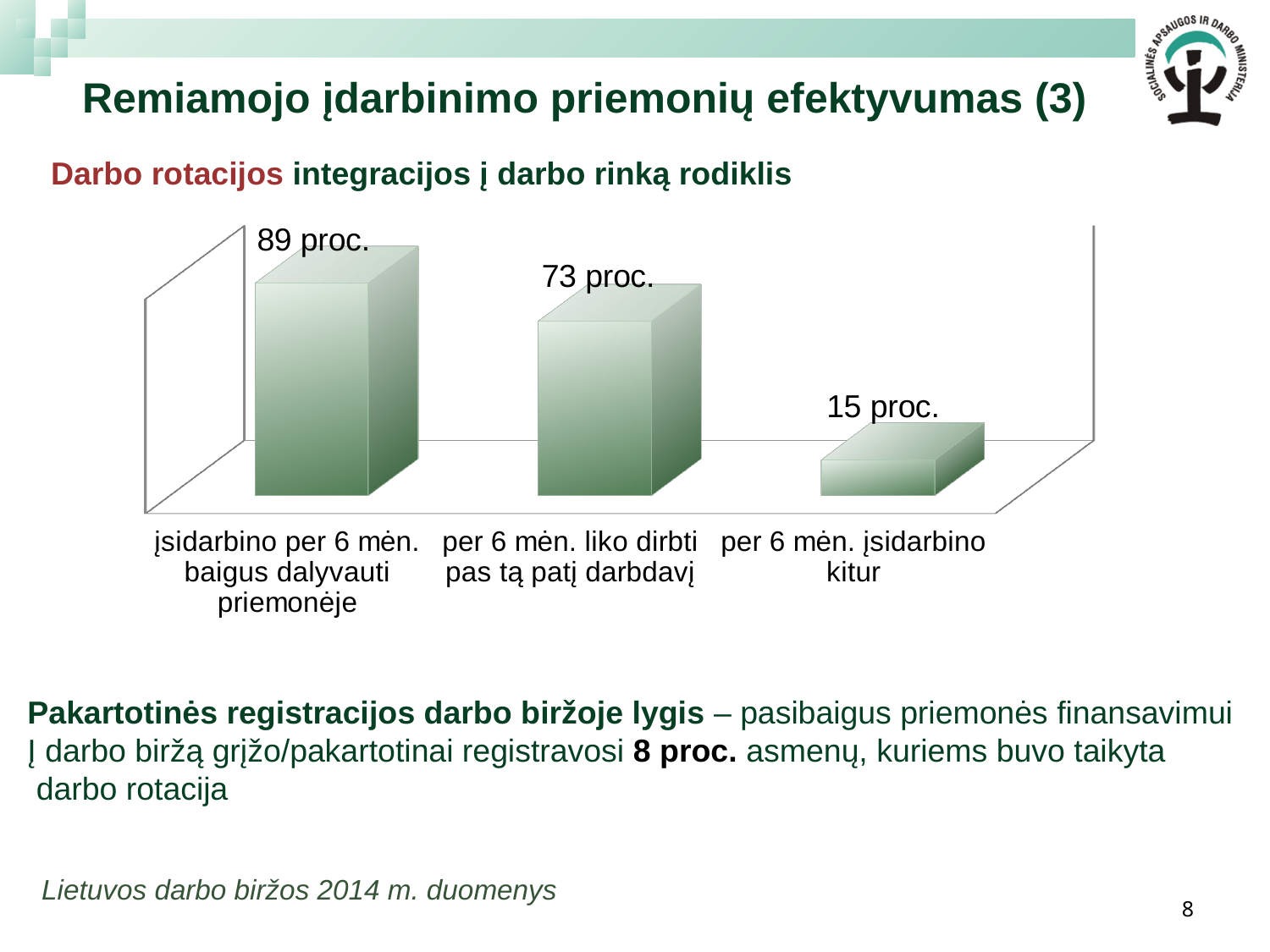
How many categories are shown in the chart? 3 What value is shown for 'per 6 mėn. įsidarbino kitur'? 15 proc. Which category has the highest value? įsidarbino per 6 mėn. baigus dalyvauti priemonėje What is the difference between the values for 'įsidarbino per 6 mėn. baigus dalyvauti priemonėje' and 'per 6 mėn. liko dirbti pas tą patį darbdavį'? 16 proc. What is the difference between the values for 'per 6 mėn. liko dirbti pas tą patį darbdavį' and 'per 6 mėn. įsidarbino kitur'? 58 proc. Which is larger: the value for 'per 6 mėn. liko dirbti pas tą patį darbdavį' or for 'per 6 mėn. įsidarbino kitur'? per 6 mėn. liko dirbti pas tą patį darbdavį Which category has the lowest value? per 6 mėn. įsidarbino kitur What kind of chart is shown on the slide? bar chart What value is shown for 'per 6 mėn. liko dirbti pas tą patį darbdavį'? 73 proc. What is the heading shown above the chart? Darbo rotacijos integracijos į darbo rinką rodiklis Do the values rise or fall from left to right across the categories? fall What value is shown for 'įsidarbino per 6 mėn. baigus dalyvauti priemonėje'? 89 proc.